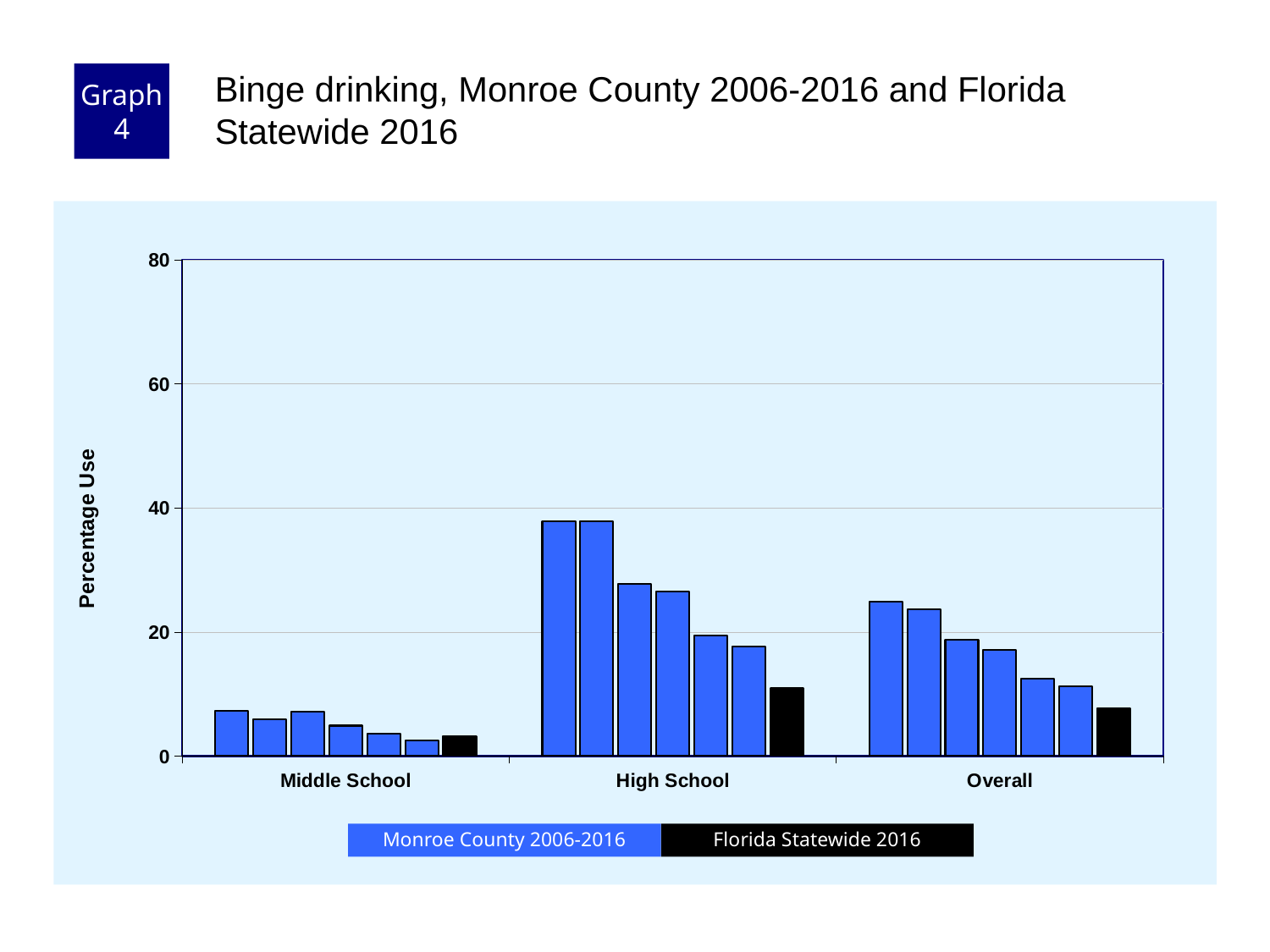
Is the Florida Statewide 2016 value for Middle School greater or less than 20? less How many categories are shown on the x axis? 3 What colour are the Florida Statewide 2016 bars? black Is the Florida Statewide 2016 value for High School greater or less than 20? less Which is larger, the Florida Statewide 2016 value for High School or for Middle School? High School Which category contains the shortest bars? Middle School Within the High School category, do the Monroe County 2006-2016 bars rise or fall from left to right? fall Is the tallest Monroe County bar for High School greater or less than 40? less Which category contains the tallest bar? High School How many series does the legend list? 2 What kind of chart is shown on the slide? bar chart